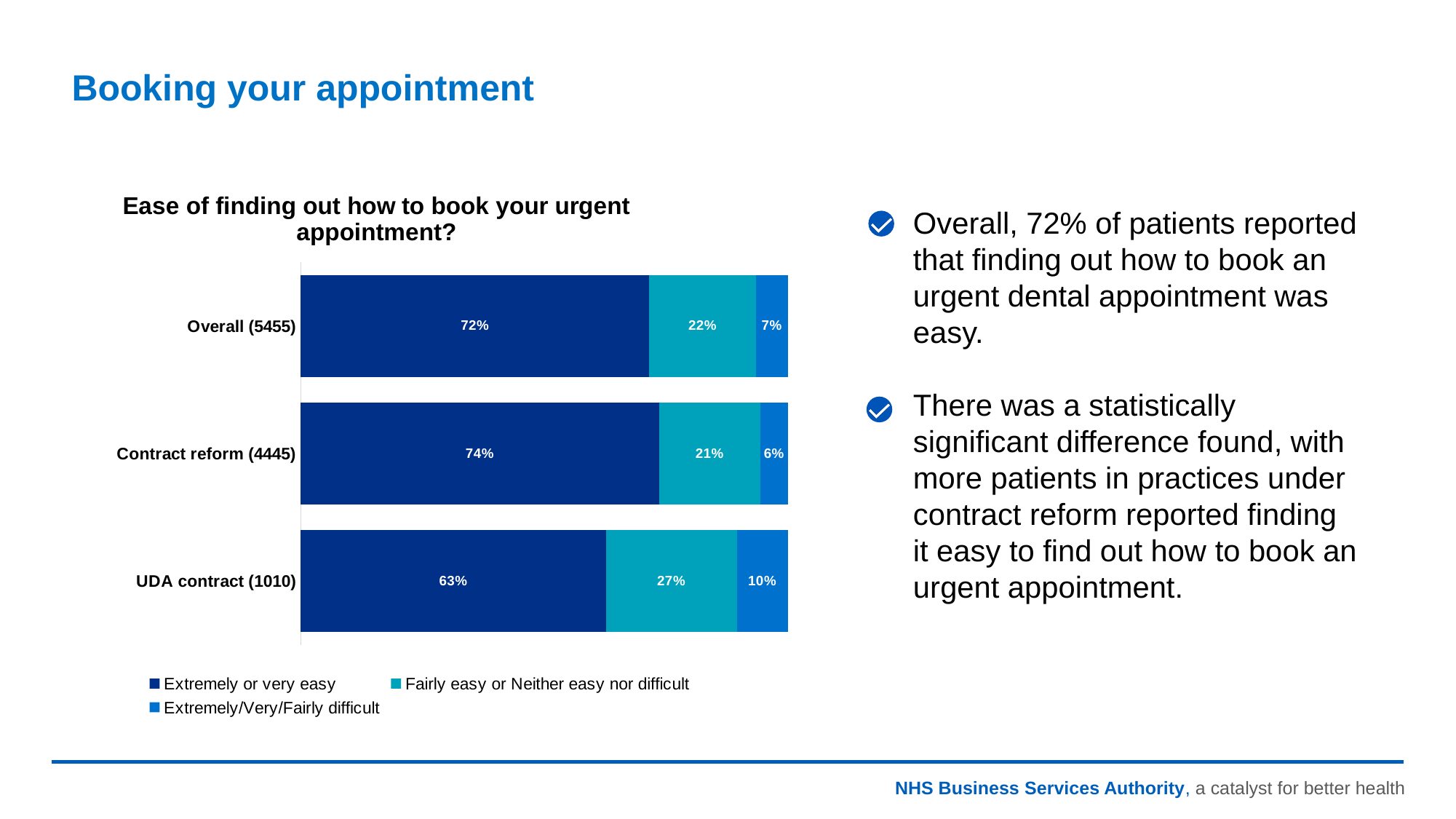
Which legend entry is shown in the darkest blue colour? Extremely or very easy What kind of chart is shown on the slide? Stacked bar chart How many categories are shown on the chart? 3 What percentage of Contract reform (4445) respondents answered Fairly easy or Neither easy nor difficult? 21% Which category has the highest share of Extremely or very easy responses? Contract reform (4445) Which is larger: the Extremely/Very/Fairly difficult share for UDA contract (1010) or for Overall (5455)? UDA contract (1010) What is the title of the chart? Ease of finding out how to book your urgent appointment? Which category has the lowest share of Extremely or very easy responses? UDA contract (1010) What is the difference in the Extremely or very easy percentage between Contract reform (4445) and UDA contract (1010)? 11 percentage points How many series does the legend list? 3 What percentage of Overall (5455) respondents found it Extremely or very easy? 72% What percentage of UDA contract (1010) respondents found it Extremely/Very/Fairly difficult? 10%